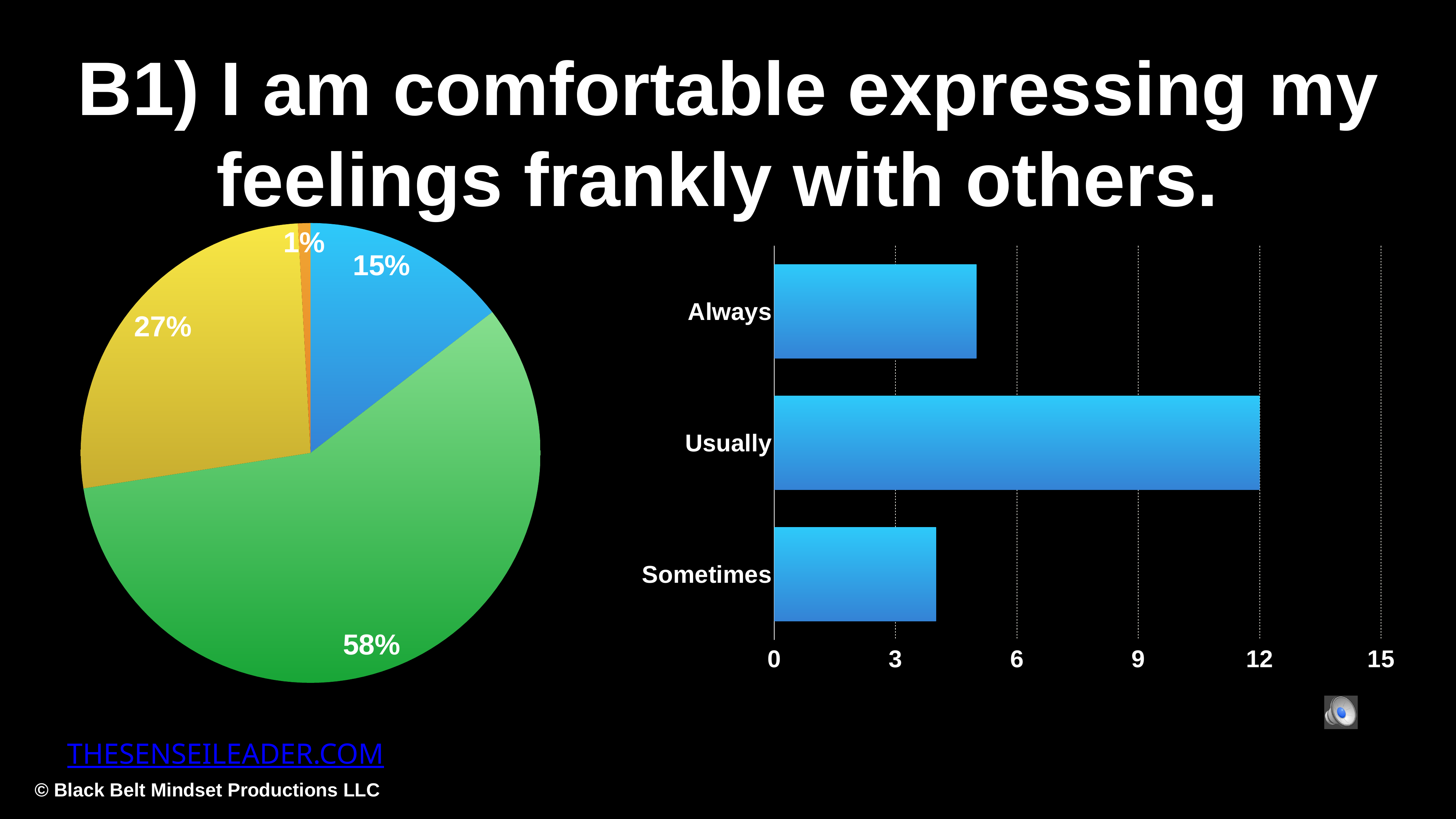
On the bar chart on the right, is the value for Always greater or less than 6? less On the bar chart on the right, which is larger, the value for Always or the value for Sometimes? Always On the bar chart on the right, is the value for Sometimes greater or less than 6? less On the pie chart on the left, what percentage does the smallest (orange) slice show? 1% How many categories are shown on the bar chart on the right? 3 On the pie chart on the left, what percentage does the largest (green) slice show? 58% On the bar chart on the right, what is the value for Usually? 12 On the bar chart on the right, which category has the lowest value? Sometimes On the bar chart on the right, which category has the highest value? Usually What kind of chart is the chart on the right of the slide? bar chart How many slices does the pie chart on the left have? 4 On the bar chart on the right, is the value for Always greater or less than 3? greater